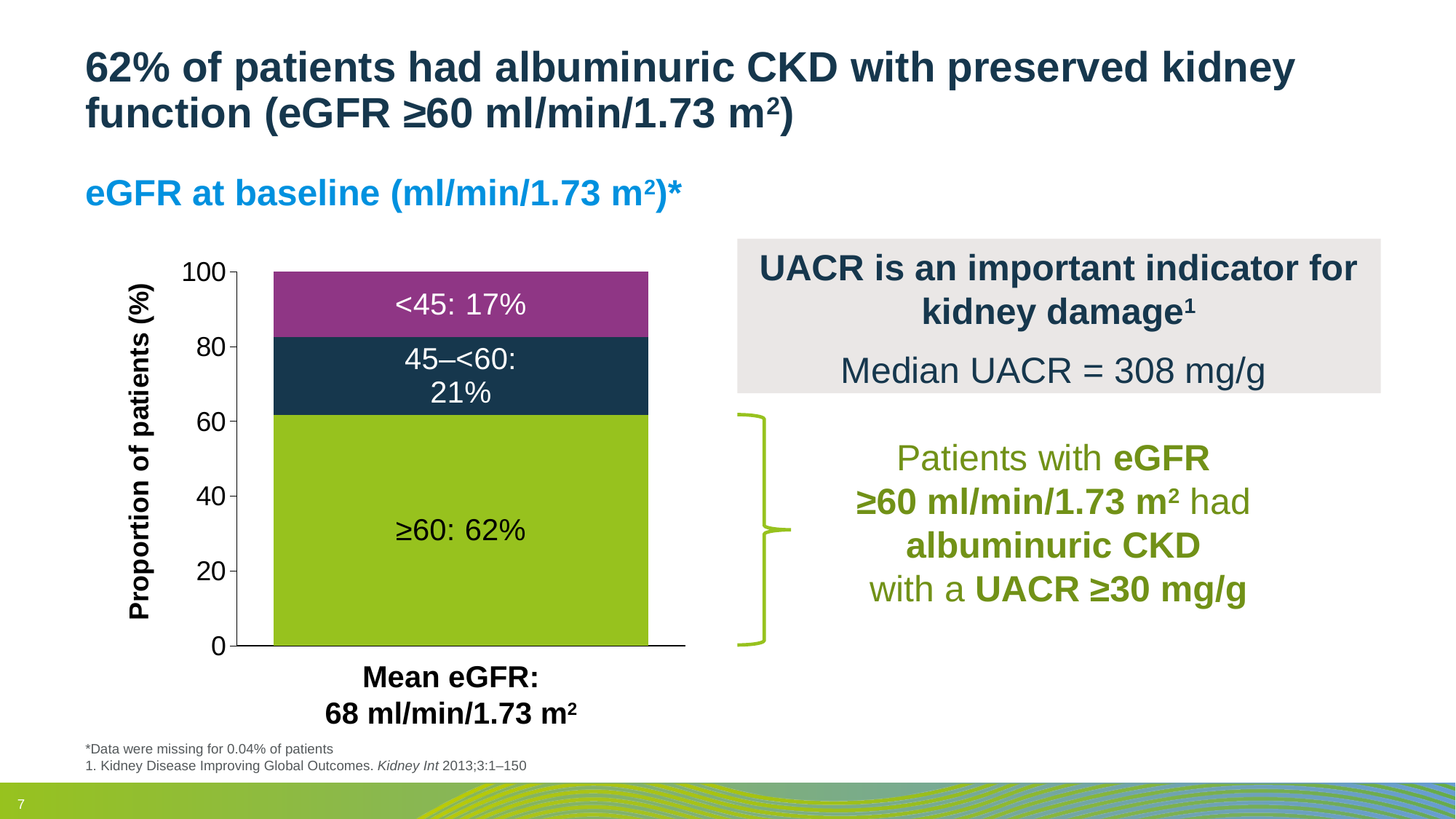
What is the total of the three segments in the stacked bar? 100% How many eGFR categories are shown in the stacked bar? 3 What type of chart is shown on the slide? Stacked bar chart Which eGFR category has the smallest proportion of patients? <45 What proportion of patients had an eGFR of ≥60 at baseline? 62% What is the difference in percentage points between the ≥60 and <45 eGFR categories? 45 Which eGFR category has the largest proportion of patients? ≥60 Which category has a larger proportion of patients: 45–<60 or <45? 45–<60 What mean eGFR is given below the bar? 68 ml/min/1.73 m² What proportion of patients had an eGFR of <45 at baseline? 17% What is the label on the y-axis of the chart? Proportion of patients (%) What proportion of patients had an eGFR of 45–<60 at baseline? 21%